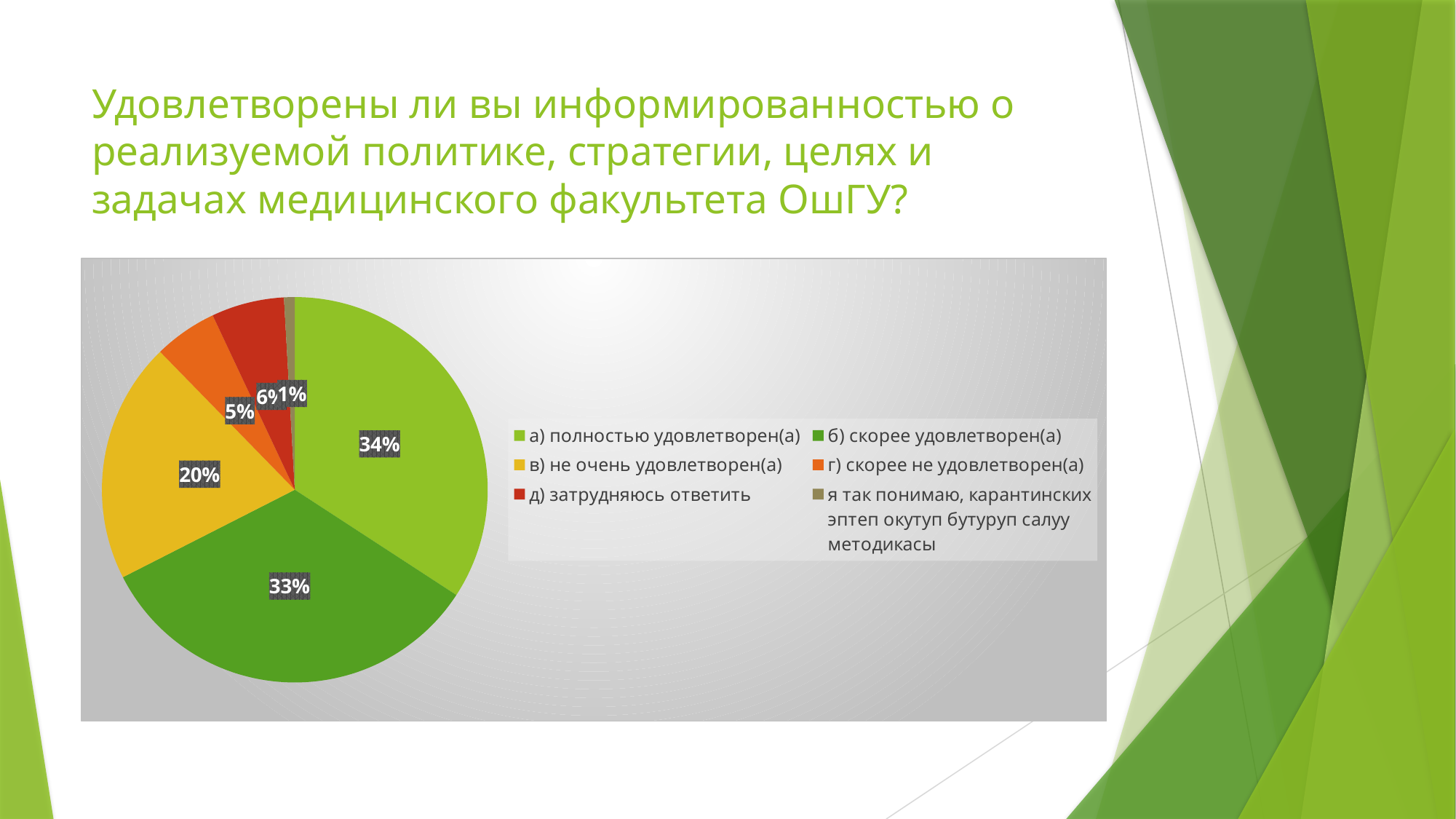
What share of respondents answered "б) скорее удовлетворен(а)"? 33% What share of respondents answered "а) полностью удовлетворен(а)"? 34% How many slices does the pie chart have? 6 What is the difference between the shares for "а) полностью удовлетворен(а)" and "в) не очень удовлетворен(а)"? 14% What share of respondents answered "в) не очень удовлетворен(а)"? 20% Which answer option has the largest share of the pie? а) полностью удовлетворен(а) Which is larger: the share for "д) затрудняюсь ответить" or the share for "г) скорее не удовлетворен(а)"? д) затрудняюсь ответить What share of respondents answered "г) скорее не удовлетворен(а)"? 5% What share of respondents answered "д) затрудняюсь ответить"? 6% What kind of chart is shown on the slide? pie chart What colour is the slice for "в) не очень удовлетворен(а)"? yellow Which answer option has the smallest share of the pie? я так понимаю, карантинских эптеп окутуп бутуруп салуу методикасы